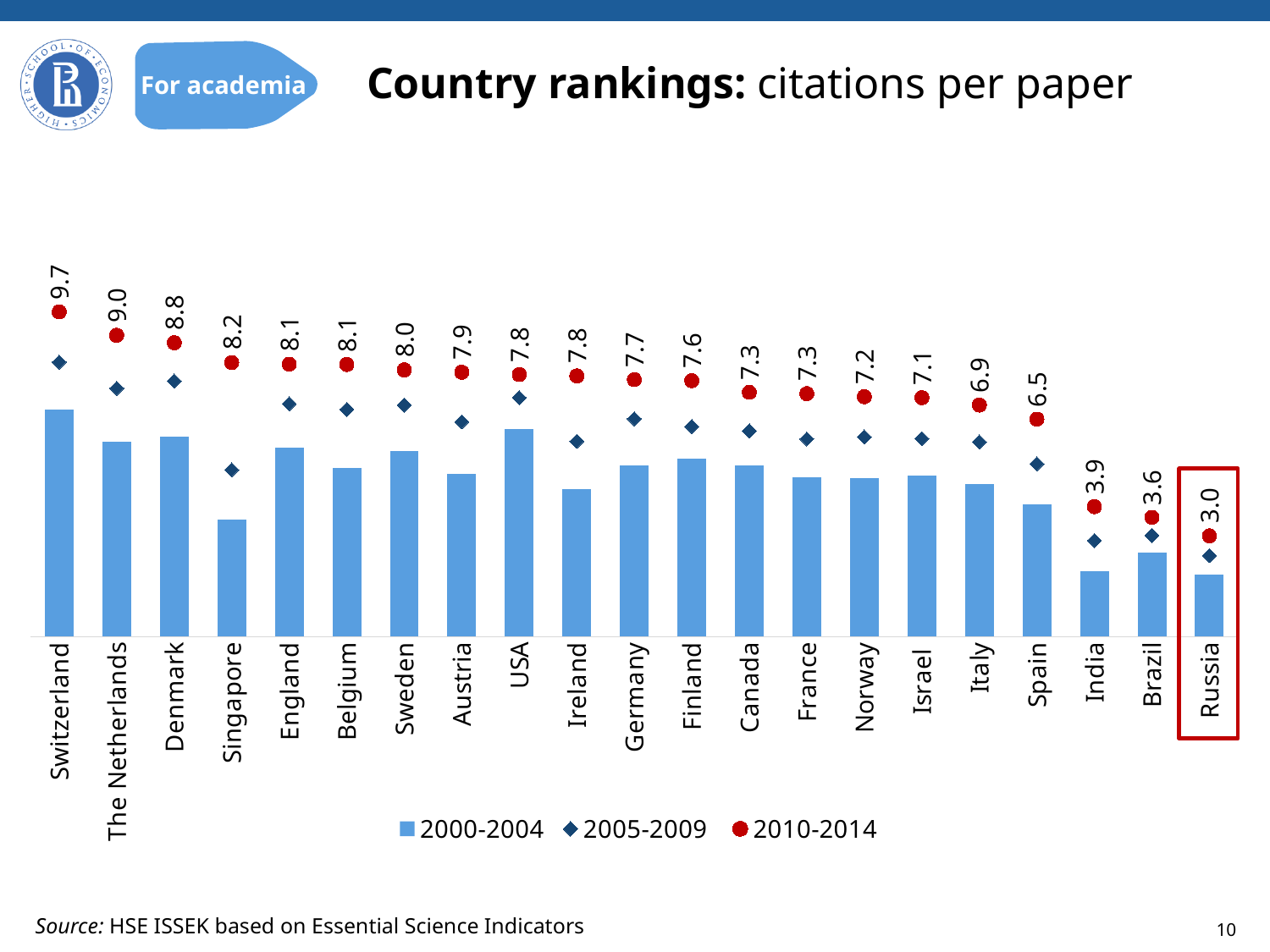
What is the 2010-2014 citations per paper value for Russia? 3.0 Do the 2010-2014 values rise or fall from left to right along the x axis? fall Which country is highlighted with a red box on the chart? Russia What is the 2010-2014 value shown for Switzerland? 9.7 What is the 2010-2014 value shown for Germany? 7.7 What is the difference between the 2010-2014 values for Switzerland and Russia? 6.7 How many series does the legend list? 3 Which country has the lowest 2010-2014 citations per paper value? Russia Which country has the highest 2010-2014 citations per paper value? Switzerland Which has the larger 2010-2014 value, Denmark or Singapore? Denmark Which country has the taller 2000-2004 bar, Switzerland or Singapore? Switzerland How many countries are shown on the x axis? 21